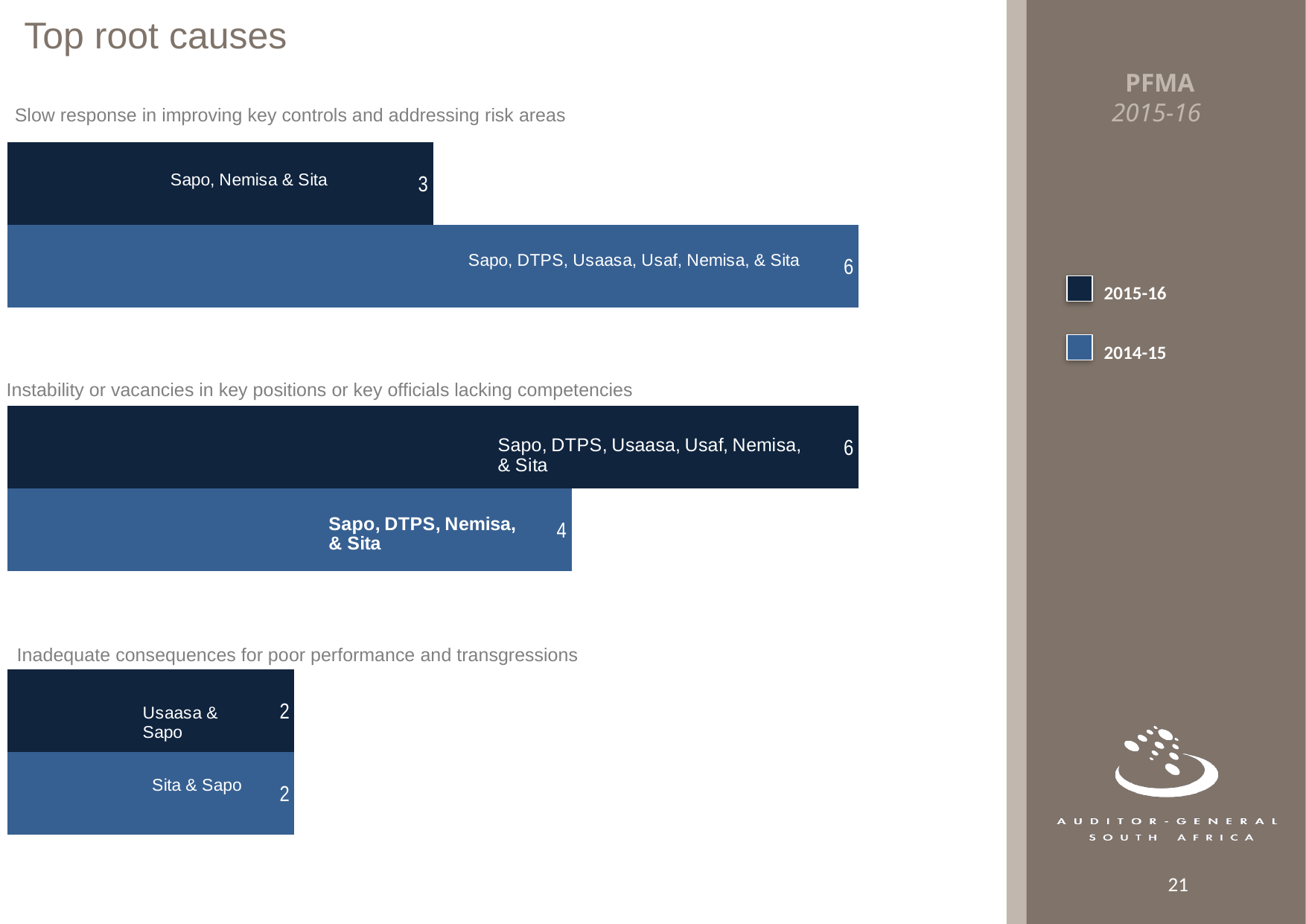
What kind of chart is used for the 'Inadequate consequences for poor performance and transgressions' root cause? Bar chart In the 'Slow response in improving key controls and addressing risk areas' chart, what is the value for 2015-16? 3 In the 'Inadequate consequences for poor performance and transgressions' chart, which entities are labelled on the 2014-15 bar? Sita & Sapo How many series does the legend on the slide list? 2 In the 'Instability or vacancies in key positions or key officials lacking competencies' chart, what is the value for 2015-16? 6 In the 'Instability or vacancies in key positions or key officials lacking competencies' chart, what is the difference between the 2015-16 and 2014-15 values? 2 In the 'Slow response in improving key controls and addressing risk areas' chart, what is the value for 2014-15? 6 In the 'Instability or vacancies in key positions or key officials lacking competencies' chart, what is the value for 2014-15? 4 In the 'Slow response in improving key controls and addressing risk areas' chart, what is the difference between the 2014-15 and 2015-16 values? 3 In the 'Instability or vacancies in key positions or key officials lacking competencies' chart, which year has the larger value, 2015-16 or 2014-15? 2015-16 In the 'Inadequate consequences for poor performance and transgressions' chart, what is the value for 2015-16? 2 In the 'Slow response in improving key controls and addressing risk areas' chart, which year has the lower value? 2015-16